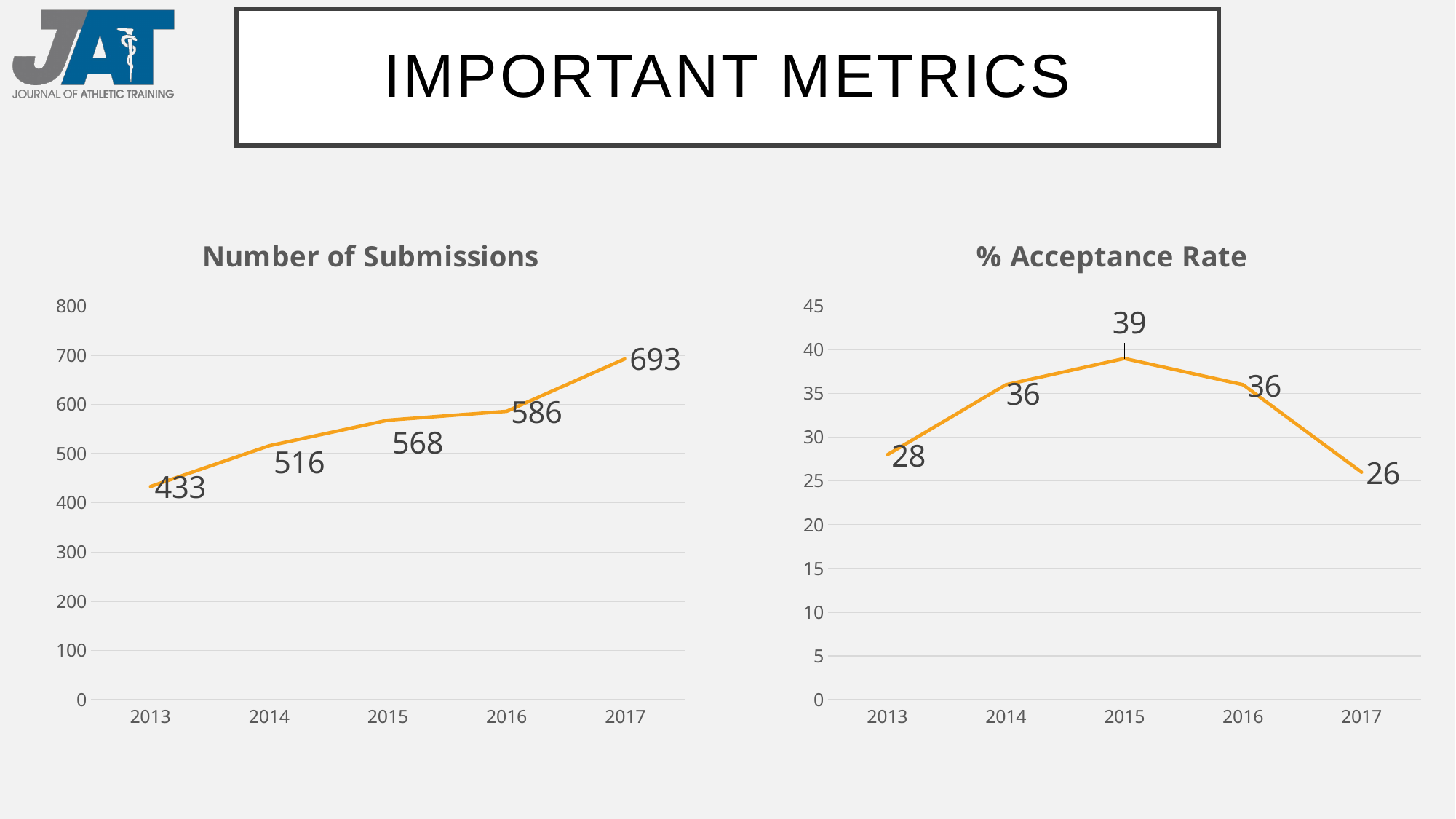
In the 'Number of Submissions' chart, which year has the highest value? 2017 In the 'Number of Submissions' chart, do the values rise or fall from 2013 to 2017? rise In the 'Number of Submissions' chart, what is the difference between the 2017 and 2013 values? 260 In the '% Acceptance Rate' chart, which year has the lowest value? 2017 What kind of chart is the '% Acceptance Rate' chart? line chart In the '% Acceptance Rate' chart, what is the difference between the 2015 and 2017 values? 13 In the '% Acceptance Rate' chart, what is the value for 2013? 28 In the '% Acceptance Rate' chart, which year has the highest value? 2015 In the '% Acceptance Rate' chart, which is larger, the value for 2014 or the value for 2017? 2014 In the 'Number of Submissions' chart, what is the value for 2015? 568 How many years are plotted in the 'Number of Submissions' chart? 5 In the 'Number of Submissions' chart, which year has the lowest value? 2013